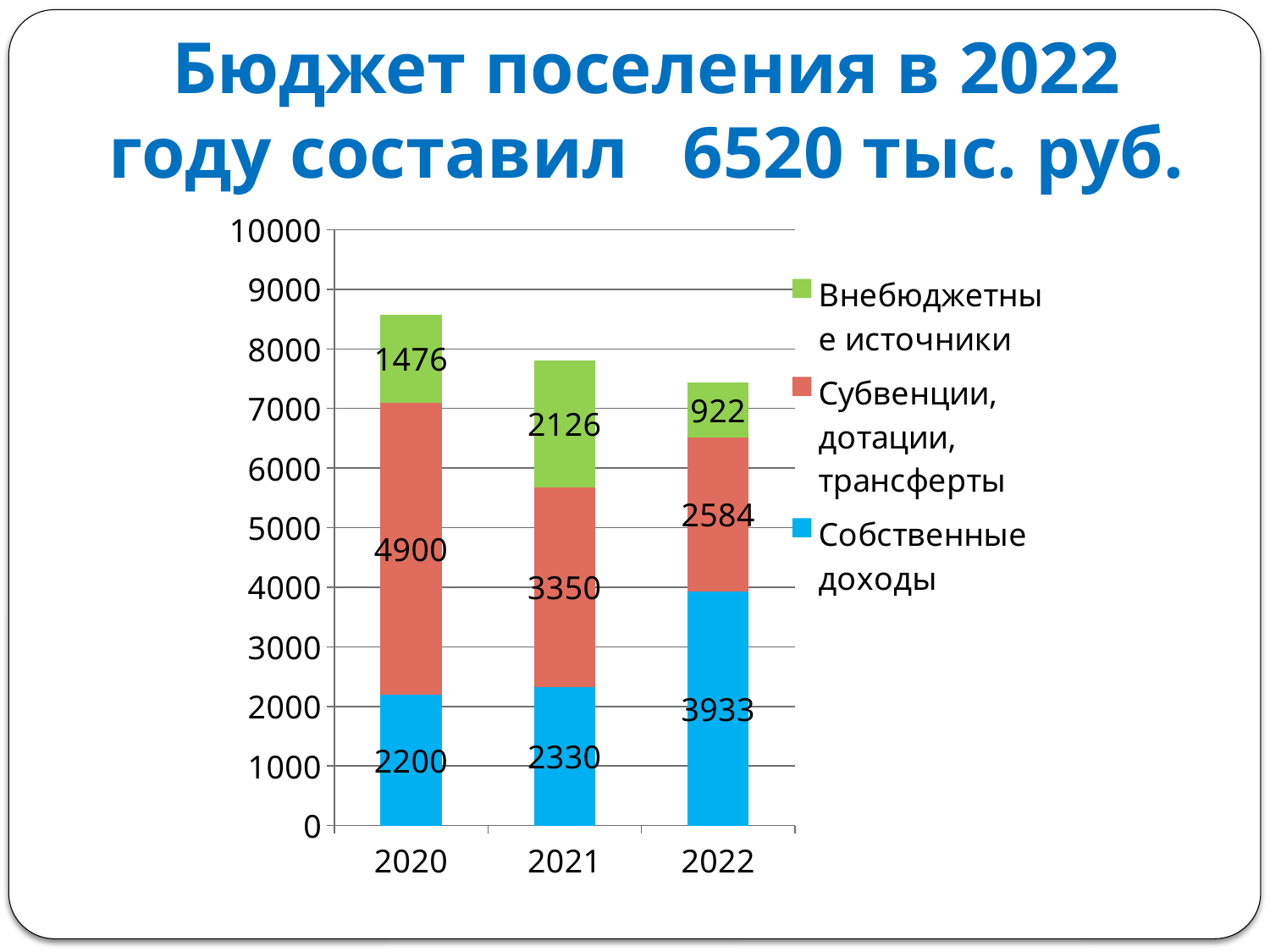
What is the value of Субвенции, дотации, трансферты for 2020? 4900 In which year is Собственные доходы the highest? 2022 What kind of chart is shown on the slide? Stacked bar chart How many years are shown on the x axis? 3 What is the difference between Субвенции, дотации, трансферты in 2020 and in 2021? 1550 What is the value of Внебюджетные источники for 2021? 2126 What is the value of Собственные доходы for 2022? 3933 Which is larger: Собственные доходы in 2021 or Субвенции, дотации, трансферты in 2021? Субвенции, дотации, трансферты in 2021 Is the total height of the 2020 bar greater or less than 8000? greater In which year is Внебюджетные источники the lowest? 2022 What is the total of the stacked bar for 2022? 7439 How many series does the legend list? 3